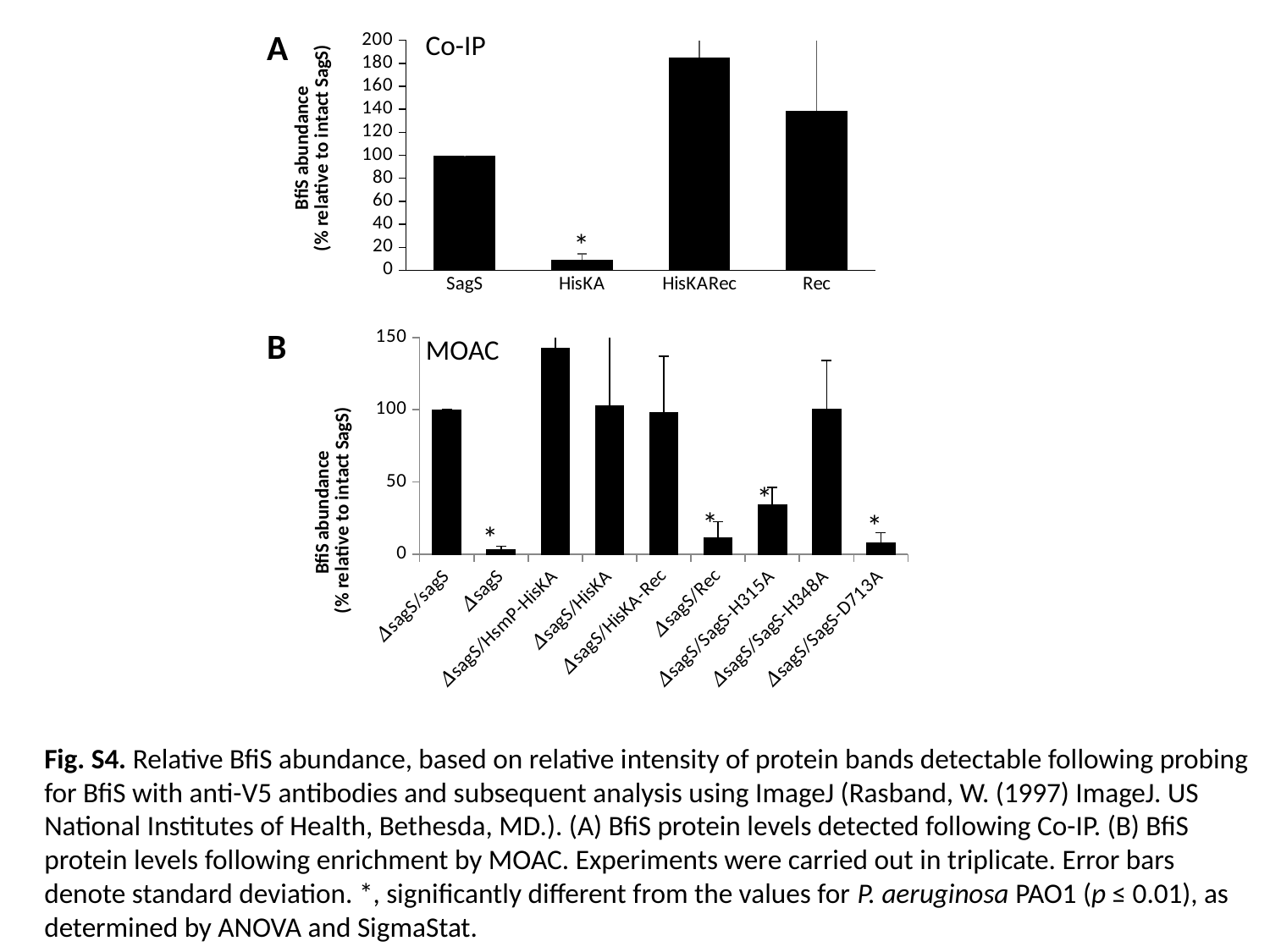
In the Co-IP chart (panel A), is the value for HisKARec greater or less than 160? greater In the MOAC chart (panel B), which category has the lowest BfiS abundance? ΔsagS How many categories are shown on the x axis of the MOAC chart (panel B)? 9 In the Co-IP chart (panel A), which category has the lowest BfiS abundance? HisKA In the Co-IP chart (panel A), which is larger, the value for Rec or the value for SagS? Rec In the Co-IP chart (panel A), which category has the highest BfiS abundance? HisKARec In the MOAC chart (panel B), which category has the highest BfiS abundance? ΔsagS/HsmP-HisKA What is the y-axis label of the MOAC chart (panel B)? BfiS abundance (% relative to intact SagS) What kind of chart is the Co-IP chart (panel A)? bar chart In the MOAC chart (panel B), is the value for ΔsagS/SagS-H315A greater or less than 50? less How many bars are in the Co-IP chart (panel A)? 4 In the Co-IP chart (panel A), is the value for HisKA greater or less than 20? less